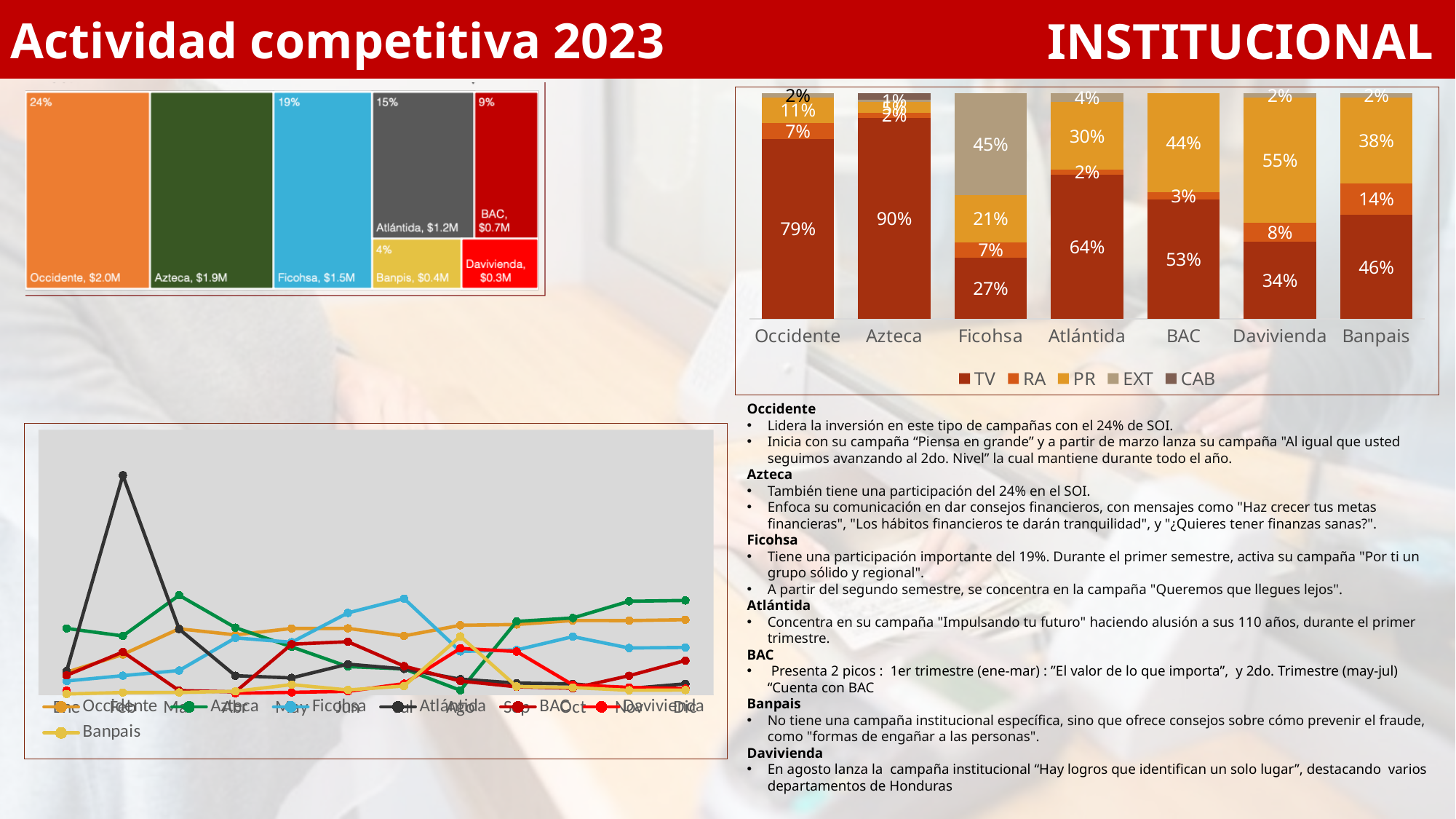
How many banks are shown on the x axis of the stacked bar chart on the right? 7 In the stacked bar chart on the right, what is the EXT share for Ficohsa? 45% In the stacked bar chart on the right, what is the TV share for Occidente? 79% In the treemap at the top left, what is the investment value shown for Ficohsa? $1.5M In the stacked bar chart on the right, what is the PR share for Davivienda? 55% How many series does the legend of the stacked bar chart on the right list? 5 In the stacked bar chart on the right, which bank has the lowest TV share? Ficohsa What kind of chart is shown at the bottom left of the slide? Line chart In the stacked bar chart on the right, which is larger: the PR share of Atlántida or the PR share of Banpais? Banpais In the stacked bar chart on the right, which bank has the highest TV share? Azteca In the treemap at the top left, which bank has the largest share? Occidente In the stacked bar chart on the right, what is the difference between the TV share of BAC and the TV share of Banpais? 7%